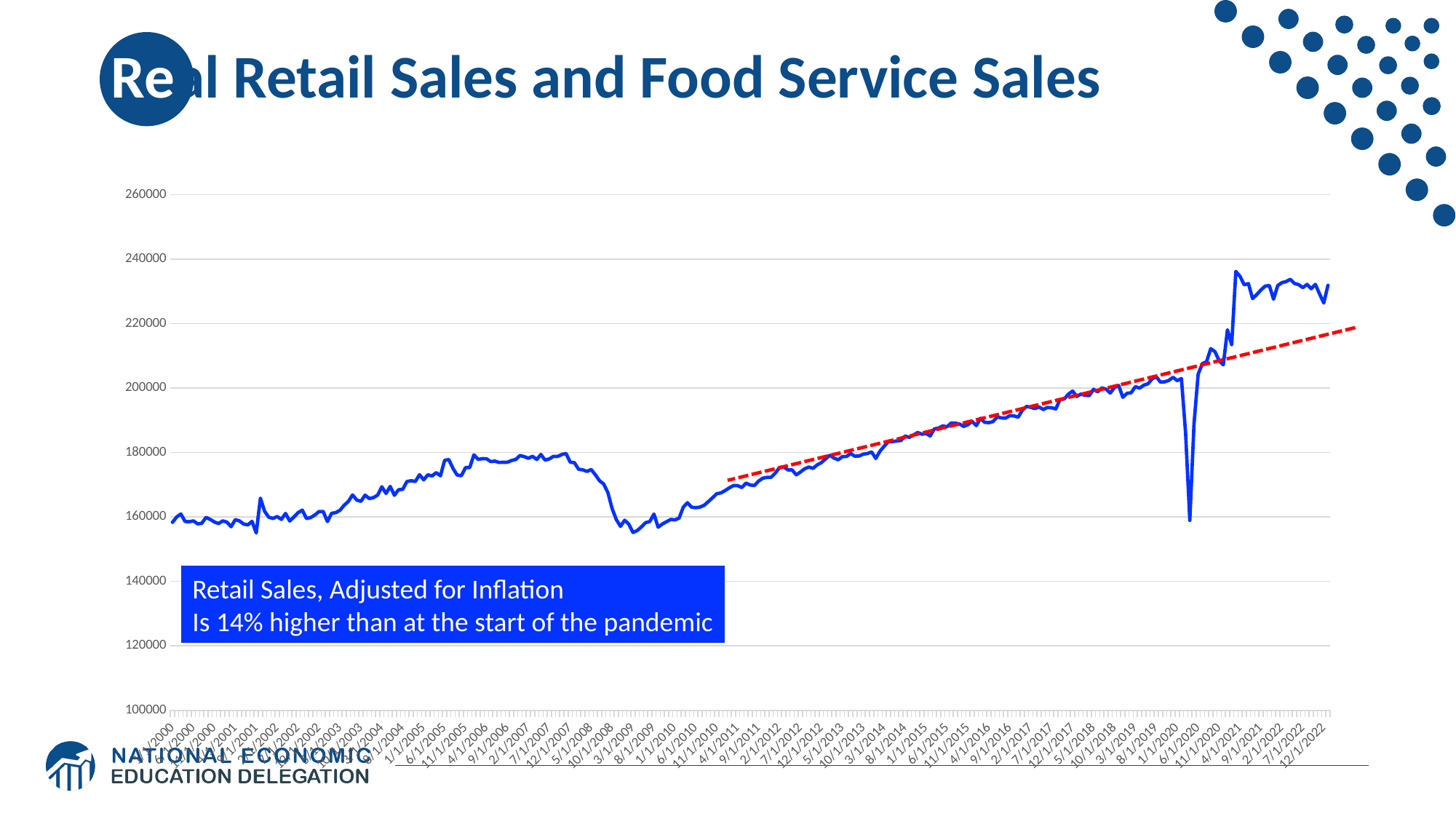
What is the highest value shown on the vertical axis? 260000 Which is larger, the value of the blue line at 12/1/2022 or at 1/1/2000? 12/1/2022 Is the value of the blue line at 1/1/2000 greater or less than 180000? less What is the title of the chart on the slide? Real Retail Sales and Food Service Sales According to the text box on the chart, how much higher are inflation-adjusted retail sales than at the start of the pandemic? 14% Which is larger, the value of the blue line at 7/1/2007 or at 3/1/2009? 7/1/2007 Overall, do the values of the blue line rise or fall from 1/1/2000 to 12/1/2022? rise In which year does the blue line reach its highest value? 2021 Is the value of the blue line at 3/1/2009 greater or less than 180000? less What kind of chart is shown on the slide? line chart Is the value of the blue line at 12/1/2022 greater or less than 220000? greater